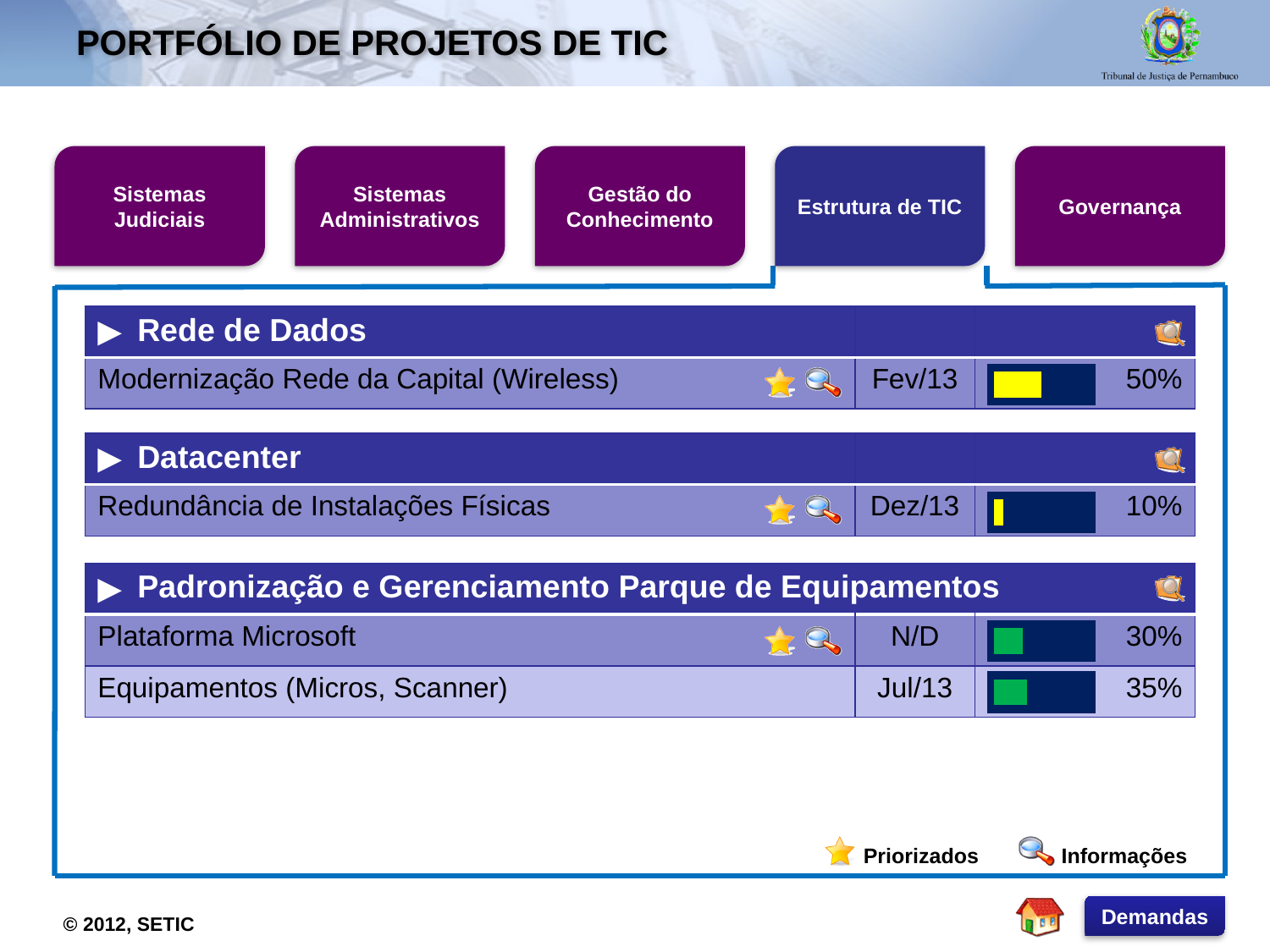
Which project has the lowest completion percentage on the slide? Redundância de Instalações Físicas Which project has the highest completion percentage on the slide? Modernização Rede da Capital (Wireless) What colour is the progress bar for the projects under Padronização e Gerenciamento Parque de Equipamentos? Green Which has a higher completion percentage, Plataforma Microsoft or Equipamentos (Micros, Scanner)? Equipamentos (Micros, Scanner) What date is shown for the Plataforma Microsoft project? N/D What is the completion percentage shown for Plataforma Microsoft? 30% What is the completion percentage shown for Modernização Rede da Capital (Wireless)? 50% What is the completion percentage shown for Equipamentos (Micros, Scanner)? 35% What date is shown for the Redundância de Instalações Físicas project? Dez/13 What is the difference in completion percentage between Modernização Rede da Capital (Wireless) and Redundância de Instalações Físicas? 40% How many projects with progress bars are listed on the slide? 4 What is the completion percentage shown for Redundância de Instalações Físicas? 10%